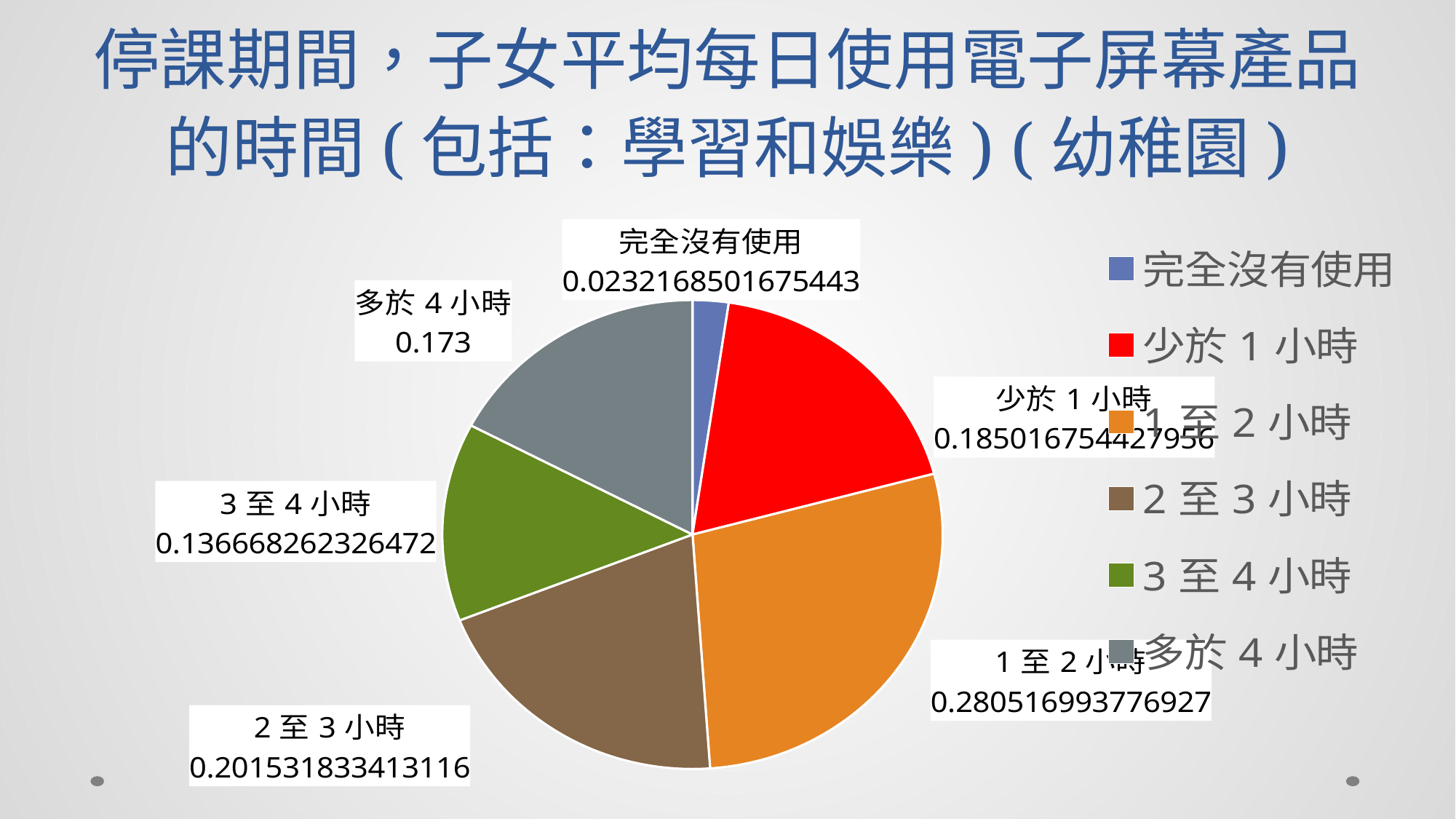
Which category has the smallest slice of the pie? 完全沒有使用 Which is larger, the value for 少於 1 小時 or the value for 2 至 3 小時? 2 至 3 小時 What is the value shown for 1 至 2 小時? 0.280516993776927 What colour is the slice for 少於 1 小時? red What kind of chart is shown on the slide? pie chart What is the value shown for 3 至 4 小時? 0.136668262326472 How many slices does the pie chart have? 6 How many entries does the legend list? 6 What is the value shown for 完全沒有使用? 0.0232168501675443 Which category has the largest slice of the pie? 1 至 2 小時 What is the difference between the value for 多於 4 小時 and the value for 3 至 4 小時? 0.036331737673528 What is the value shown for 多於 4 小時? 0.173